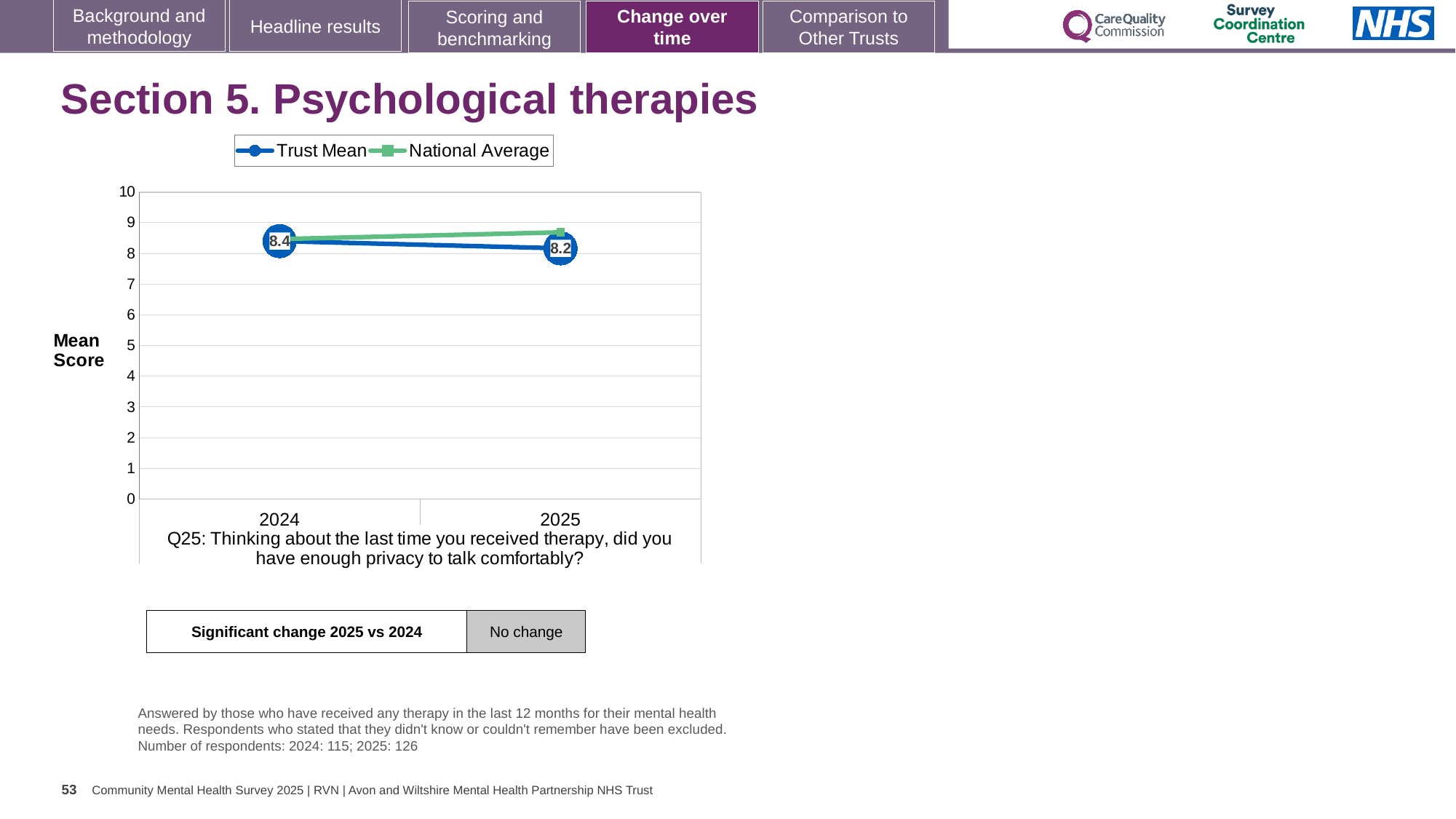
What is the Trust Mean score for 2024? 8.4 What does the y axis of the chart measure? Mean Score In 2025, which series is higher, Trust Mean or National Average? National Average Is the Trust Mean value for 2024 greater or less than 9? less Which year has the higher Trust Mean score, 2024 or 2025? 2024 What kind of chart is shown on the slide? line chart By how much did the Trust Mean score change from 2024 to 2025? -0.2 How many series does the legend list? 2 Is the National Average value for 2025 greater or less than 8? greater How many years are plotted on the x axis? 2 Does the Trust Mean rise or fall from 2024 to 2025? fall What is the Trust Mean score for 2025? 8.2